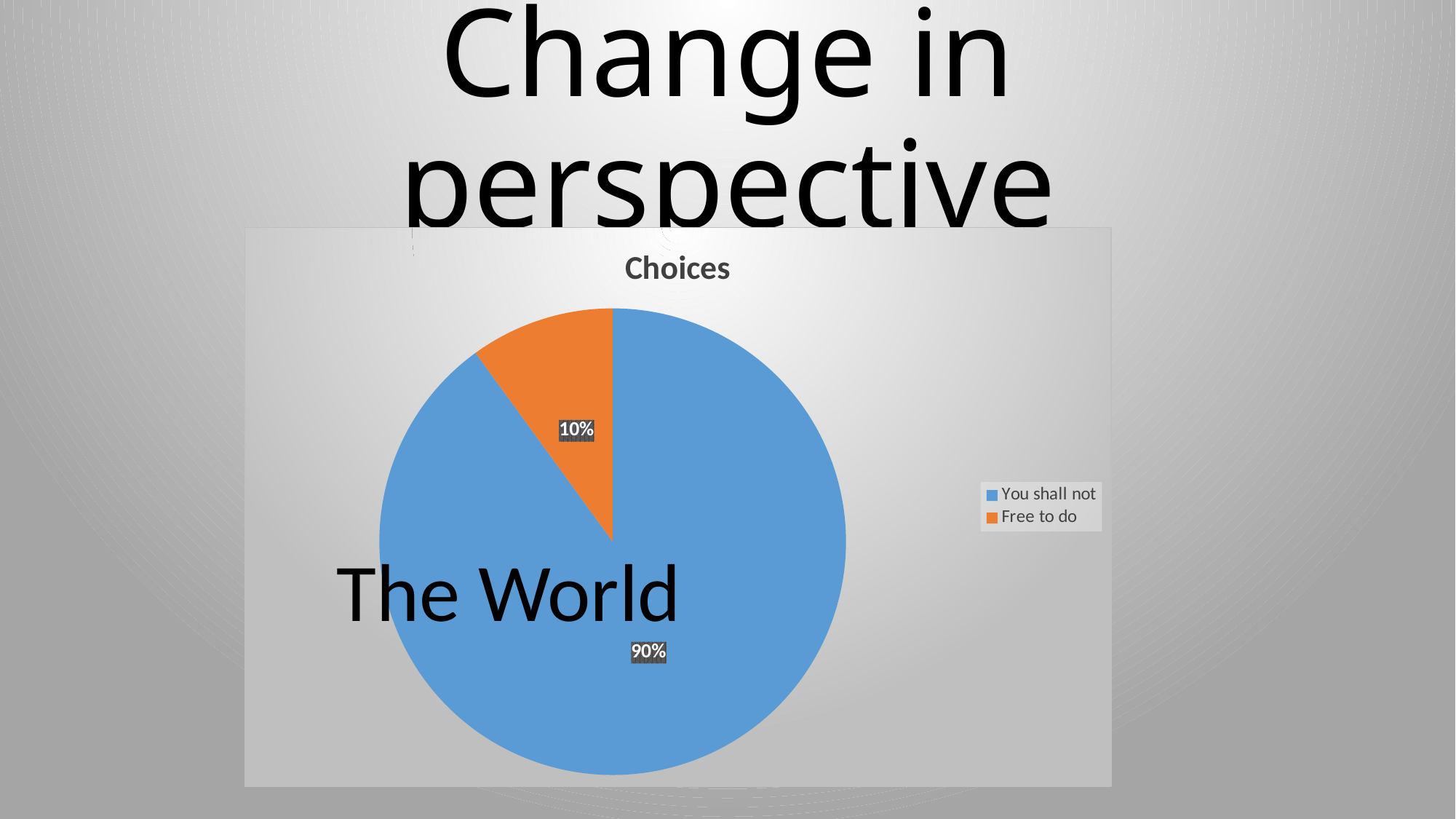
How many entries does the legend list? 2 Which slice of the pie is the largest? You shall not Which slice of the pie is the smallest? Free to do What is the difference in percentage points between the "You shall not" slice and the "Free to do" slice? 80 What type of chart is shown on the slide? pie chart What percentage of the pie is labelled "You shall not"? 90% What is the title of the chart? Choices Which is larger, the "You shall not" slice or the "Free to do" slice? You shall not What share of the pie does the "Free to do" slice represent? 10% What colour is the "Free to do" slice? orange How many slices does the pie chart have? 2 What percentage of the pie is labelled "Free to do"? 10%